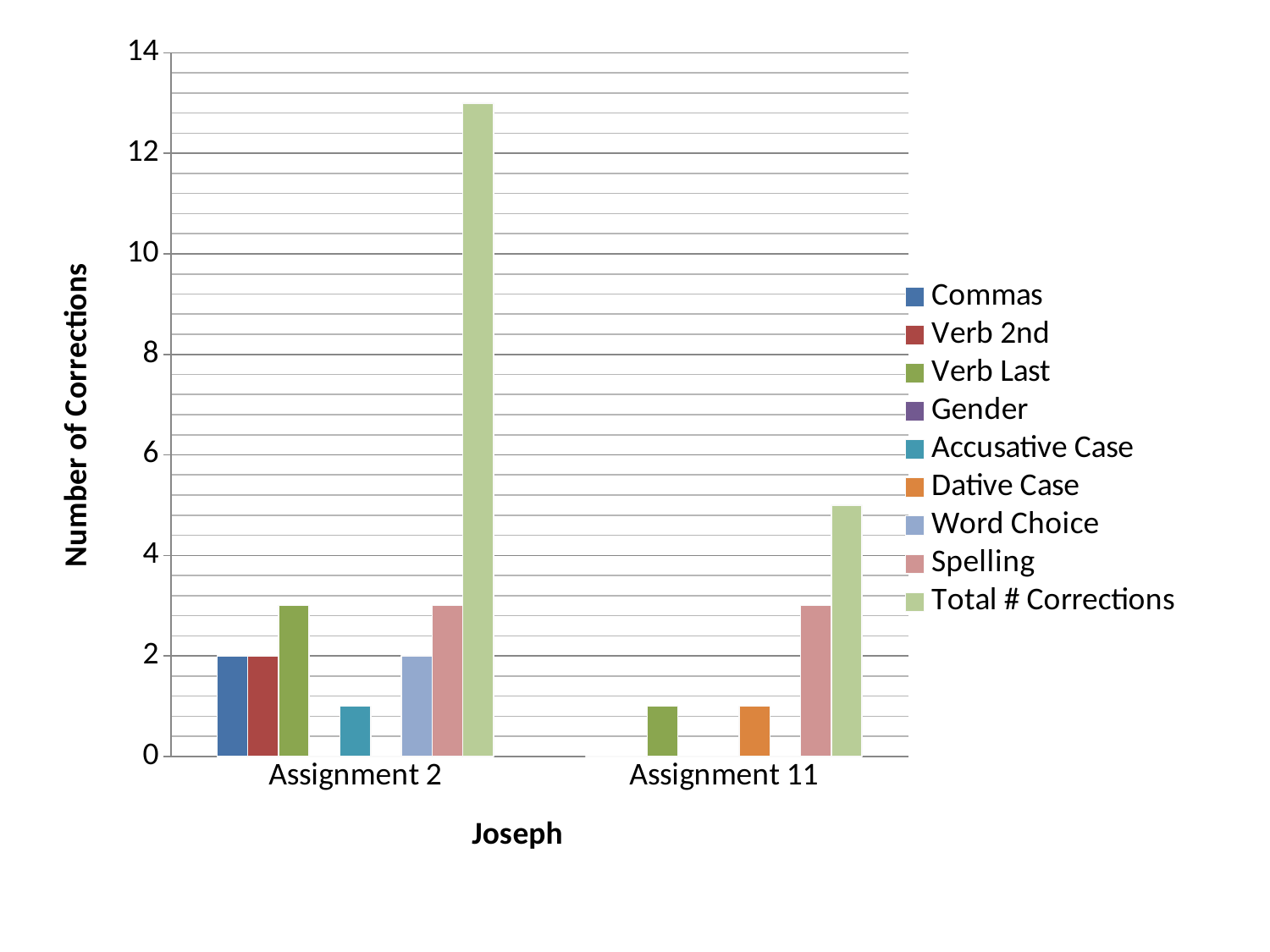
Which assignment has the higher Total # Corrections? Assignment 2 Is the value for Total # Corrections in Assignment 11 greater or less than 4? greater What is the value for Word Choice in Assignment 2? 2 How many series does the legend list? 9 What is the label of the y axis? Number of Corrections What type of chart is shown on the slide? bar chart What is the value for Commas in Assignment 2? 2 Does the Total # Corrections rise or fall from Assignment 2 to Assignment 11? fall Is the value for Total # Corrections in Assignment 2 greater or less than 12? greater Is the value for Accusative Case in Assignment 2 greater or less than 2? less How many assignment categories are shown on the x axis? 2 Which series has the highest value in Assignment 2? Total # Corrections